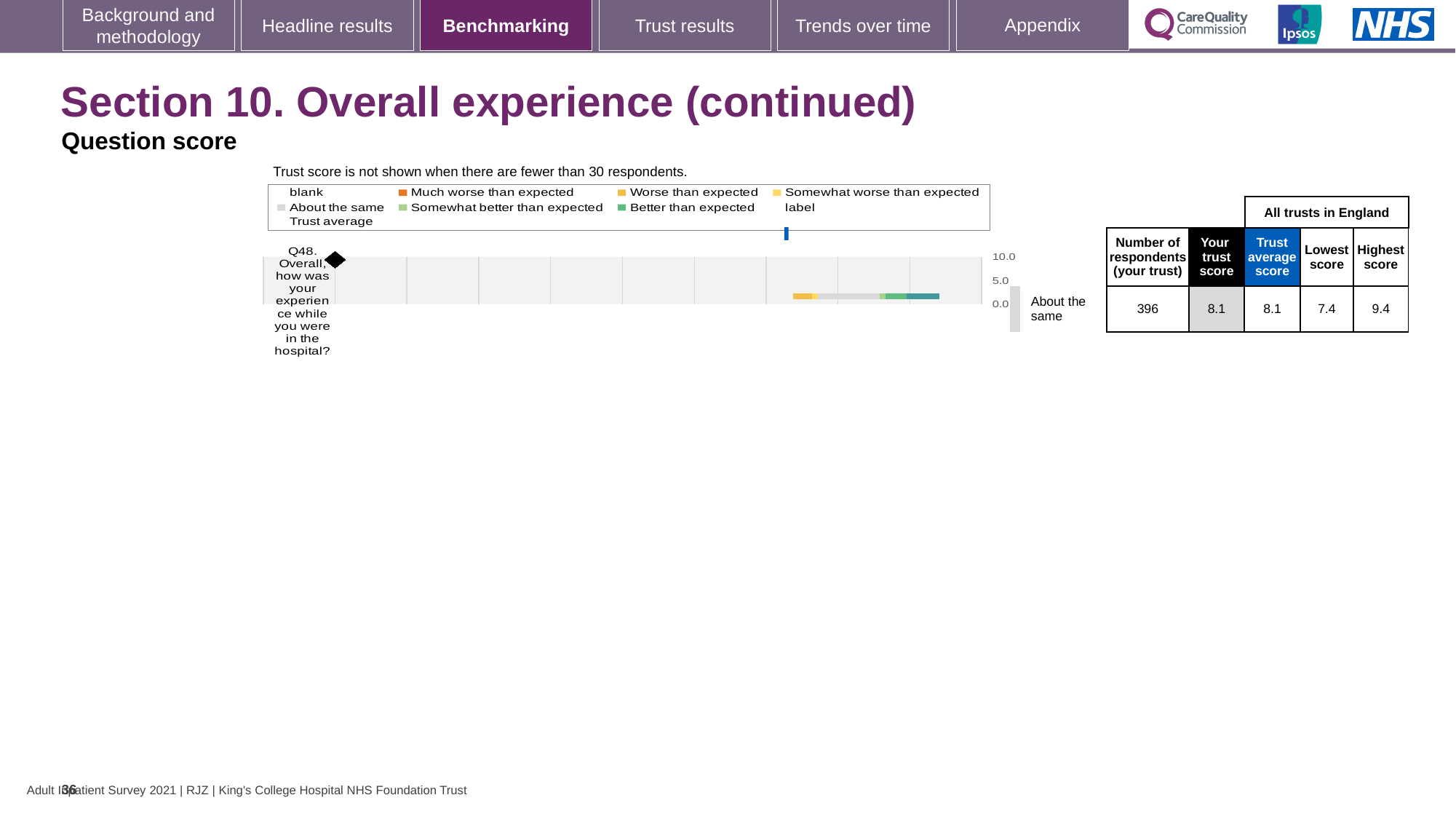
Is your trust score for Q48 higher than, lower than, or the same as the trust average score? The same How many respondents from your trust answered Q48? 396 What is the difference between the highest score and the lowest score for Q48? 2.0 What benchmark category label is shown next to the Q48 bar? About the same Is your trust score for Q48 greater or less than 5.0? greater What is the 'Your trust score' value for Q48? 8.1 What kind of chart is used to show the Q48 benchmarking result? Bar chart How many survey questions are plotted in the benchmarking chart? 1 What is the trust average score for Q48 across all trusts in England? 8.1 What is the highest score for Q48 among all trusts in England? 9.4 What is the lowest score for Q48 among all trusts in England? 7.4 Which question is plotted in the benchmarking chart? Q48. Overall, how was your experience while you were in the hospital?